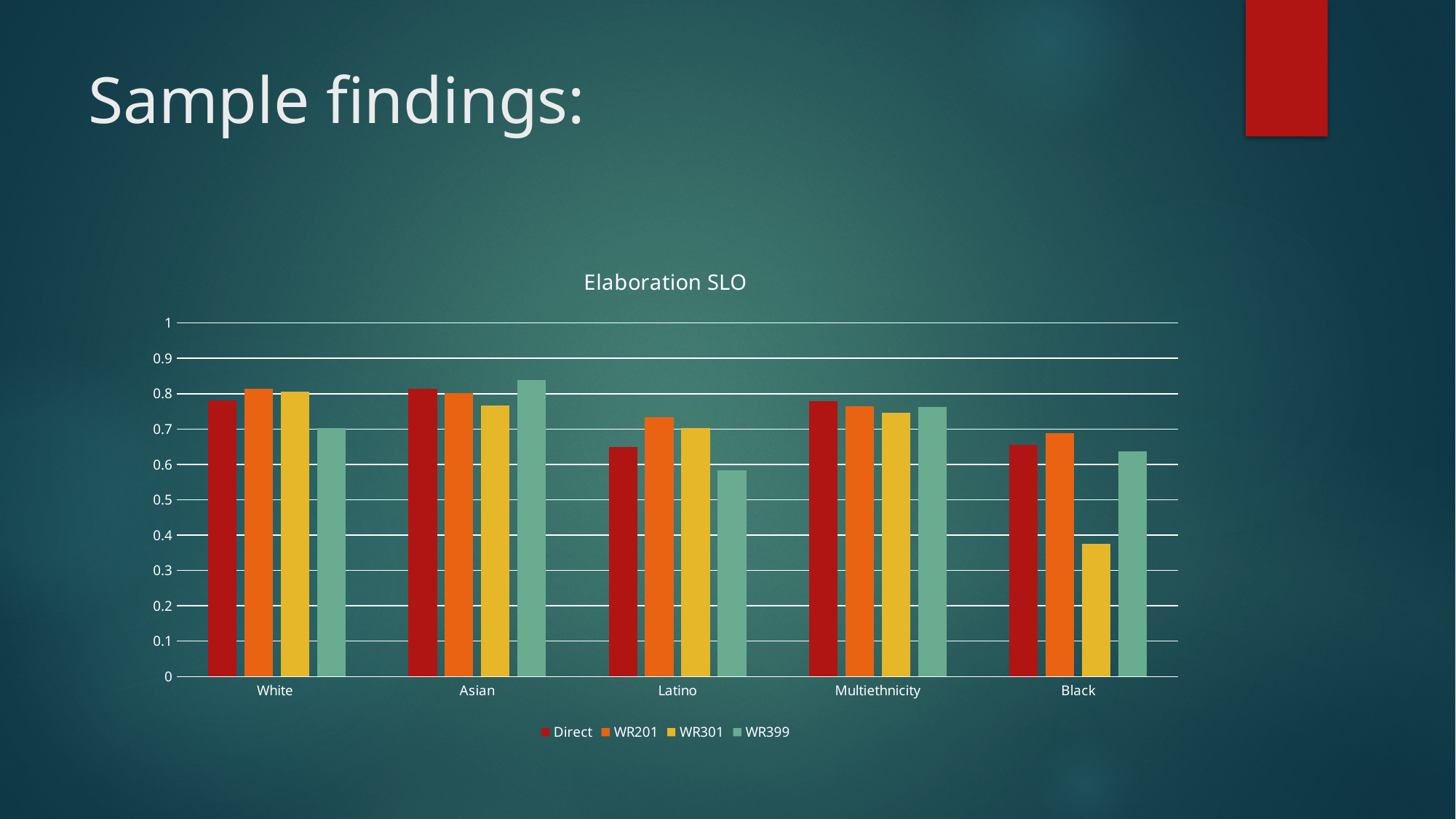
How many series does the chart's legend list? 4 Which category has the lowest WR301 value? Black Is the WR399 value for Asian greater or less than 0.8? greater What kind of chart is shown on the slide? bar chart Which category has the lowest WR399 value? Latino Which category has the highest WR399 value? Asian For Latino, which is larger: the WR201 value or the WR399 value? WR201 Is the WR399 value for Latino greater or less than 0.7? less How many categories are shown on the x axis of the chart? 5 Is the WR301 value for Black greater or less than 0.4? less What is the title of the chart? Elaboration SLO For Black, which is larger: the Direct value or the WR301 value? Direct